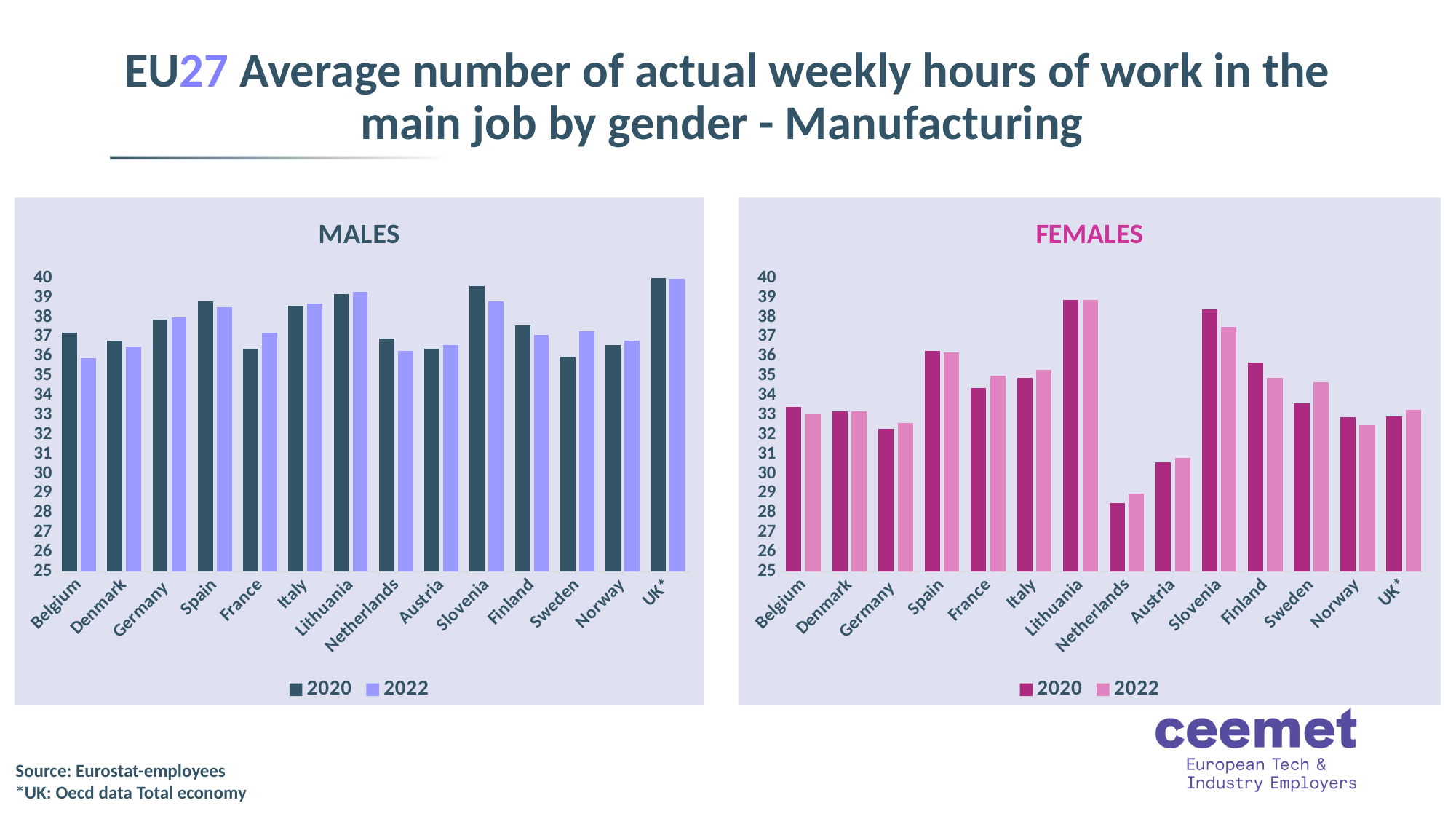
On the FEMALES chart, is the 2020 value for Lithuania greater or less than 38? greater On the FEMALES chart, which country has the lowest value for 2020? Netherlands On the FEMALES chart, is the 2020 value for Netherlands greater or less than 29? less How many countries are shown on the MALES chart? 14 How many series does the legend of the FEMALES chart list? 2 On the FEMALES chart, for Sweden, which year has the larger value, 2020 or 2022? 2022 On the MALES chart, for Belgium, which year has the larger value, 2020 or 2022? 2020 On the MALES chart, is the 2020 value for Slovenia greater or less than 39? greater Which two years are listed in the legend of the MALES chart? 2020 and 2022 What kind of chart is the MALES chart? Bar chart On the MALES chart, which country has the highest value for 2020? UK* On the FEMALES chart, which country has the highest value for 2022? Lithuania